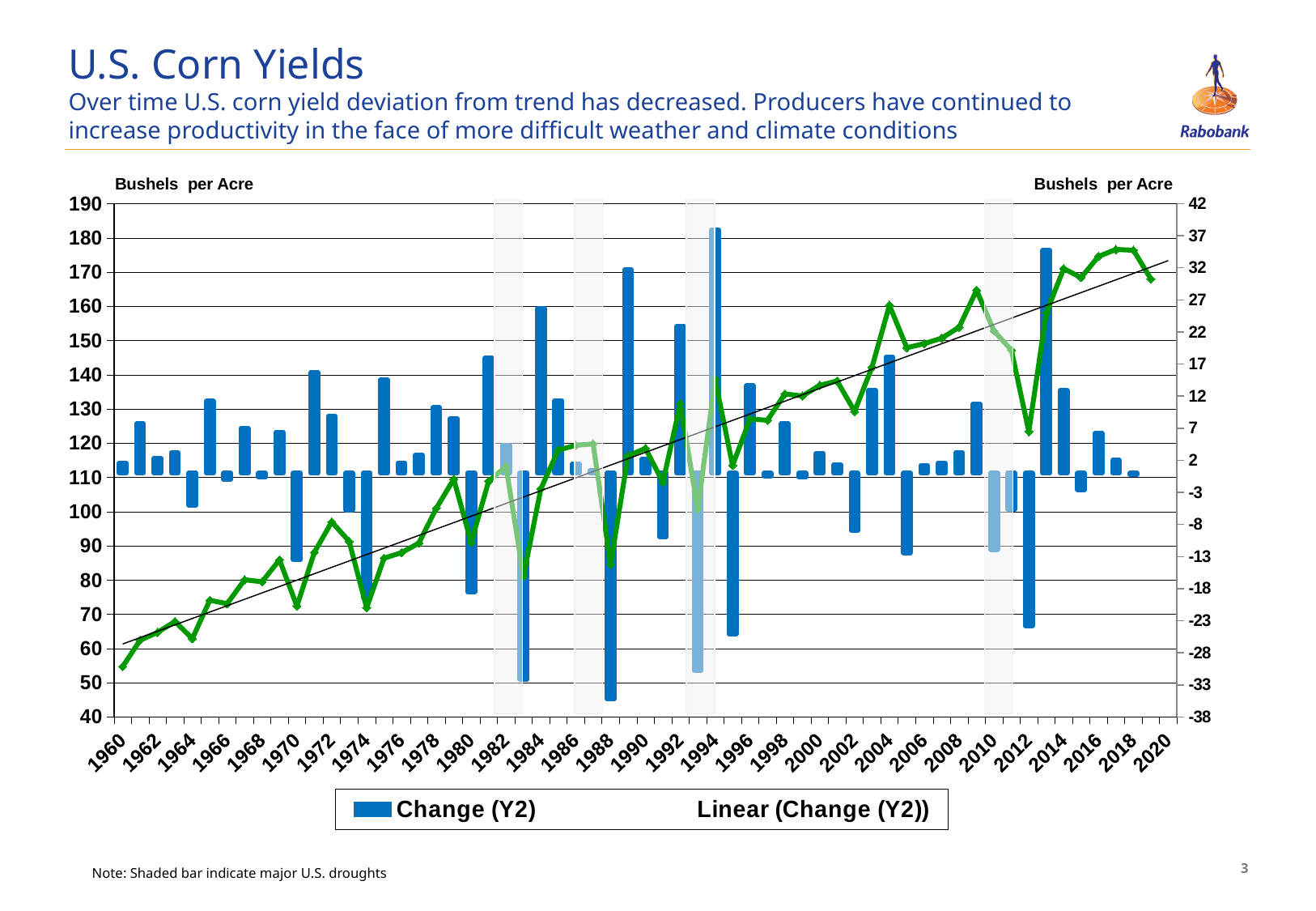
Which year has a higher green yield line value, 2002 or 2004? 2004 What is the label on the left vertical axis? Bushels per Acre Is the green yield line value for 1988 greater or less than 90 bushels per acre? less What kind of chart is shown on the slide? A combined bar and line chart Does the green yield line generally rise or fall from 1960 to 2020? Rise What are the two entries in the chart legend? Change (Y2) and Linear (Change (Y2)) How many series does the legend list? 2 Is the green yield line value for 2018 greater or less than 170 bushels per acre? greater Is the green yield line value for 1960 greater or less than 60 bushels per acre? less In which year is the Change (Y2) bar the highest? 1994 Which year has a higher green yield line value, 2017 or 2019? 2017